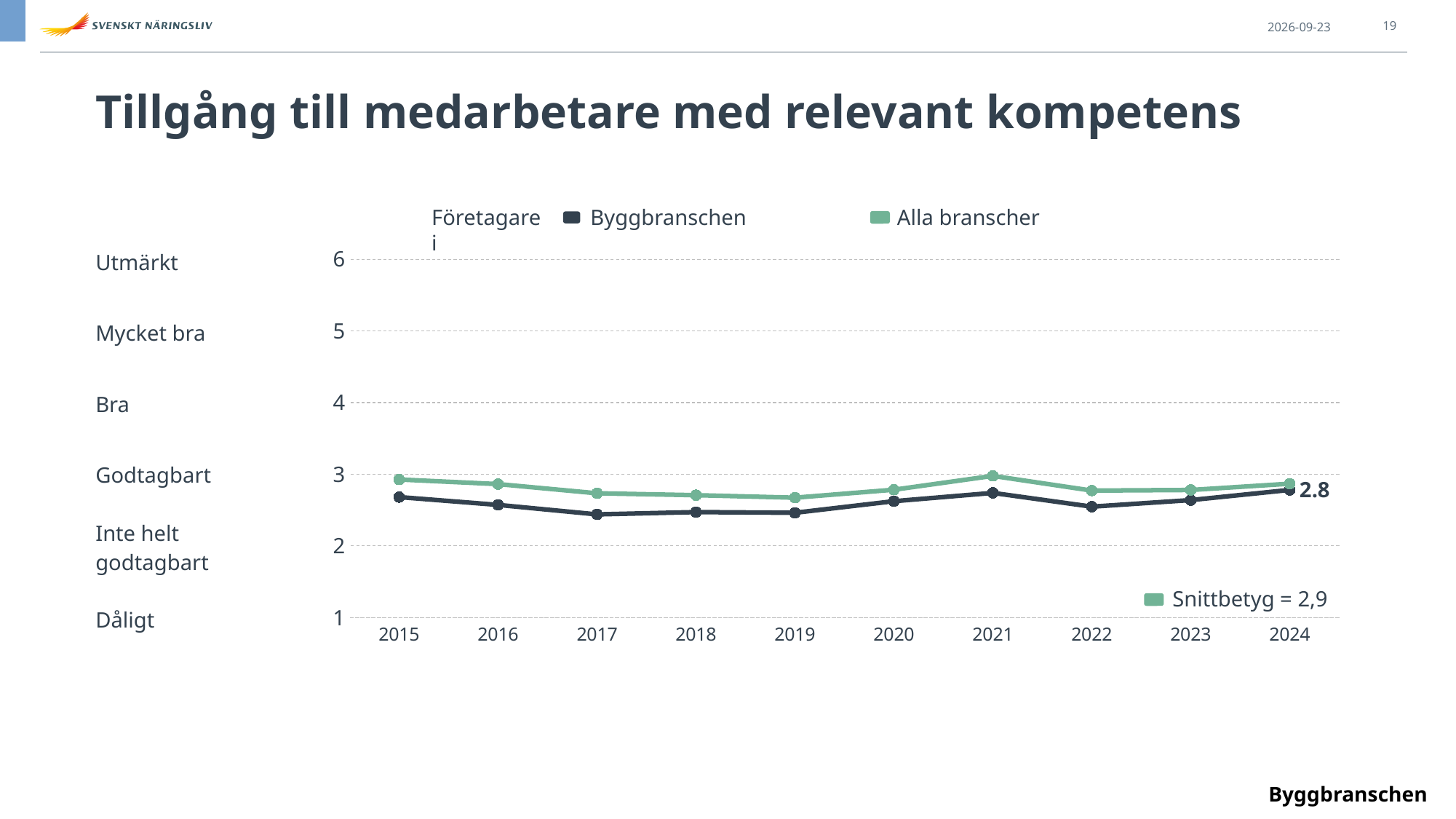
What is the title of the chart on the slide? Tillgång till medarbetare med relevant kompetens Is the value for Byggbranschen in 2017 greater or less than 3? less Is the value for Alla branscher in 2018 greater or less than 3? less What is the value for Byggbranschen in 2024? 2.8 In which year does the Alla branscher line reach its highest value? 2021 Is the value for Byggbranschen in 2019 greater or less than 2? greater How many series does the chart legend list? 2 What kind of chart is shown on the slide? line chart In 2017, which series has the higher value, Byggbranschen or Alla branscher? Alla branscher Does the Byggbranschen line rise or fall from 2022 to 2024? rise How many years are plotted along the x axis? 10 What Snittbetyg value is shown in the chart? 2,9